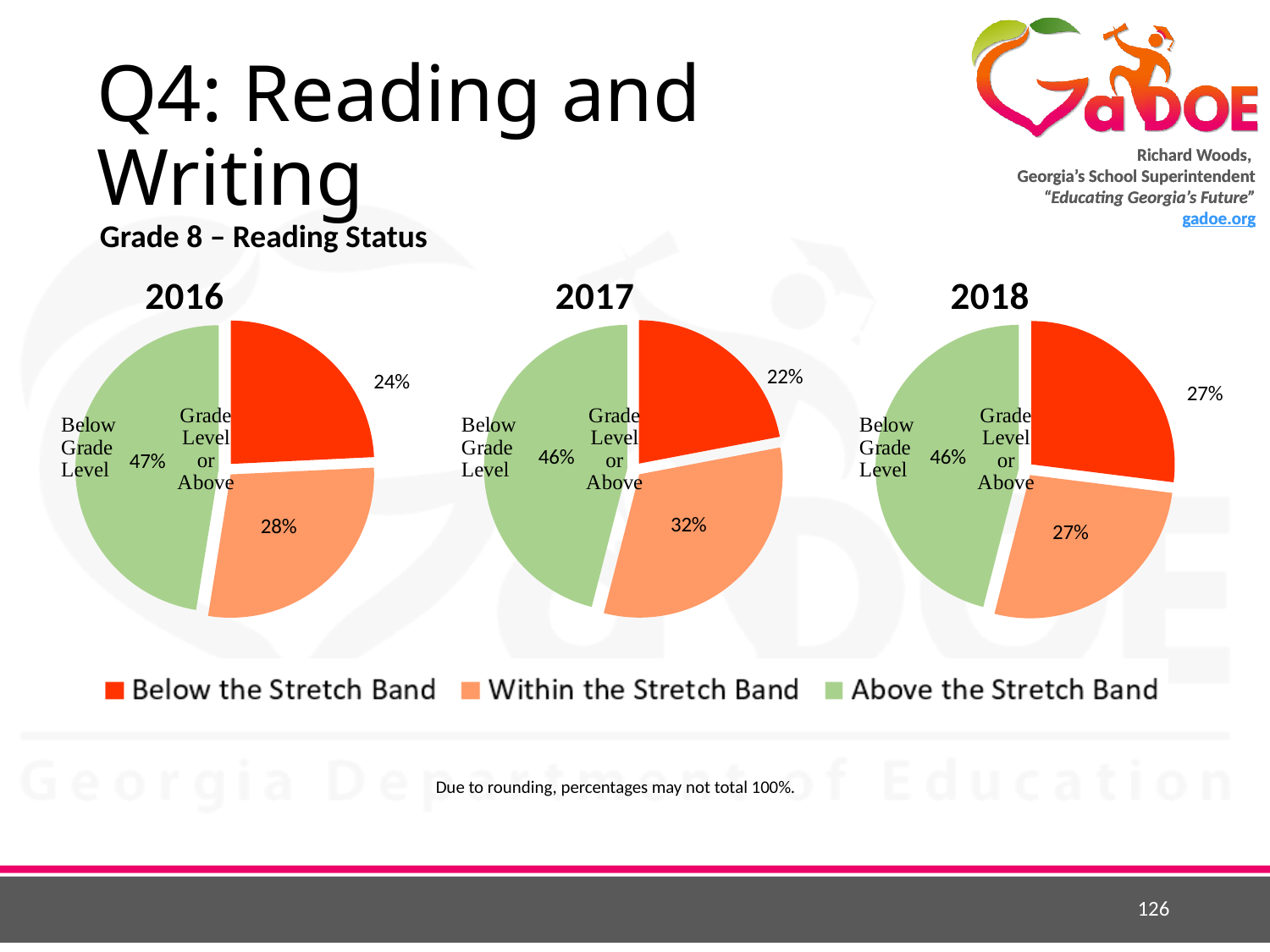
In the 2016 pie chart, which category has the largest share? Above the Stretch Band In the 2017 pie chart, which is larger: Within the Stretch Band or Below the Stretch Band? Within the Stretch Band In the 2016 pie chart, what percentage is Below the Stretch Band? 24% Which colour represents Below the Stretch Band in the legend? Red How many categories does the legend list? 3 Across the 2016, 2017 and 2018 pie charts, does the Above the Stretch Band share rise or fall from 2016 to 2018? Fall In the 2017 pie chart, what percentage is Within the Stretch Band? 32% What kind of charts are shown on the slide? Pie charts In the 2016 pie chart, what is the difference between the Above the Stretch Band share and the Within the Stretch Band share? 19 percentage points How many pie charts are shown on the slide? 3 In the 2018 pie chart, what percentage is Above the Stretch Band? 46% In the 2017 pie chart, which category has the smallest share? Below the Stretch Band